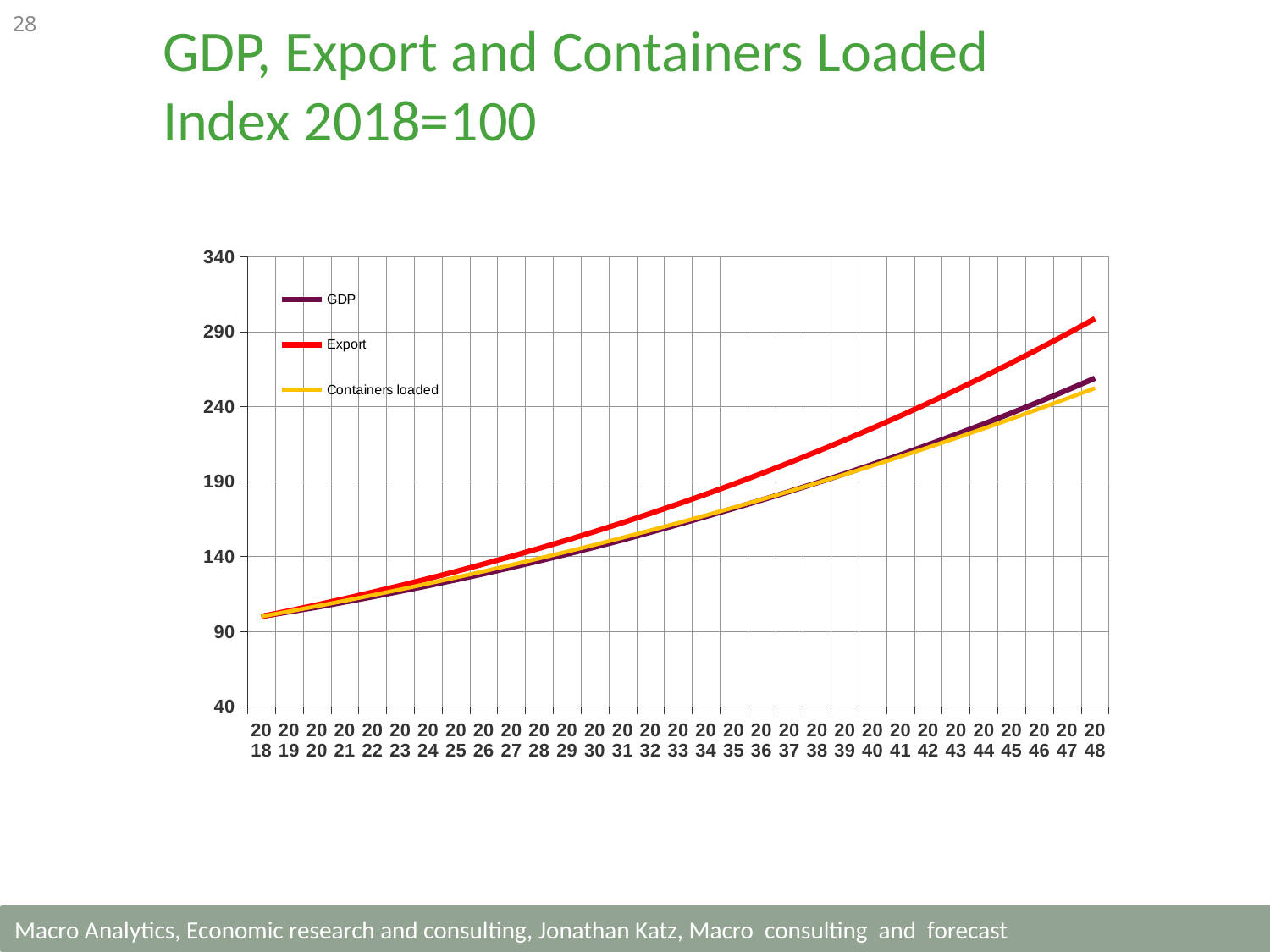
Is the value for Export in 2048 greater or less than 240? greater Do the values of the Export series rise or fall from 2018 to 2048? rise What is the index value of the series in the base year 2018? 100 How many series does the legend list? 3 How many years are plotted along the x axis? 31 What kind of chart is shown on the slide? line chart What colour is the Export line in the chart? red In 2048, which is larger, the value for Export or the value for GDP? Export Which series has the lowest value in 2048? Containers loaded Is the value for GDP in 2048 greater or less than 290? less Which series has the highest value in 2048? Export Is the value for Export in 2030 greater or less than 190? less